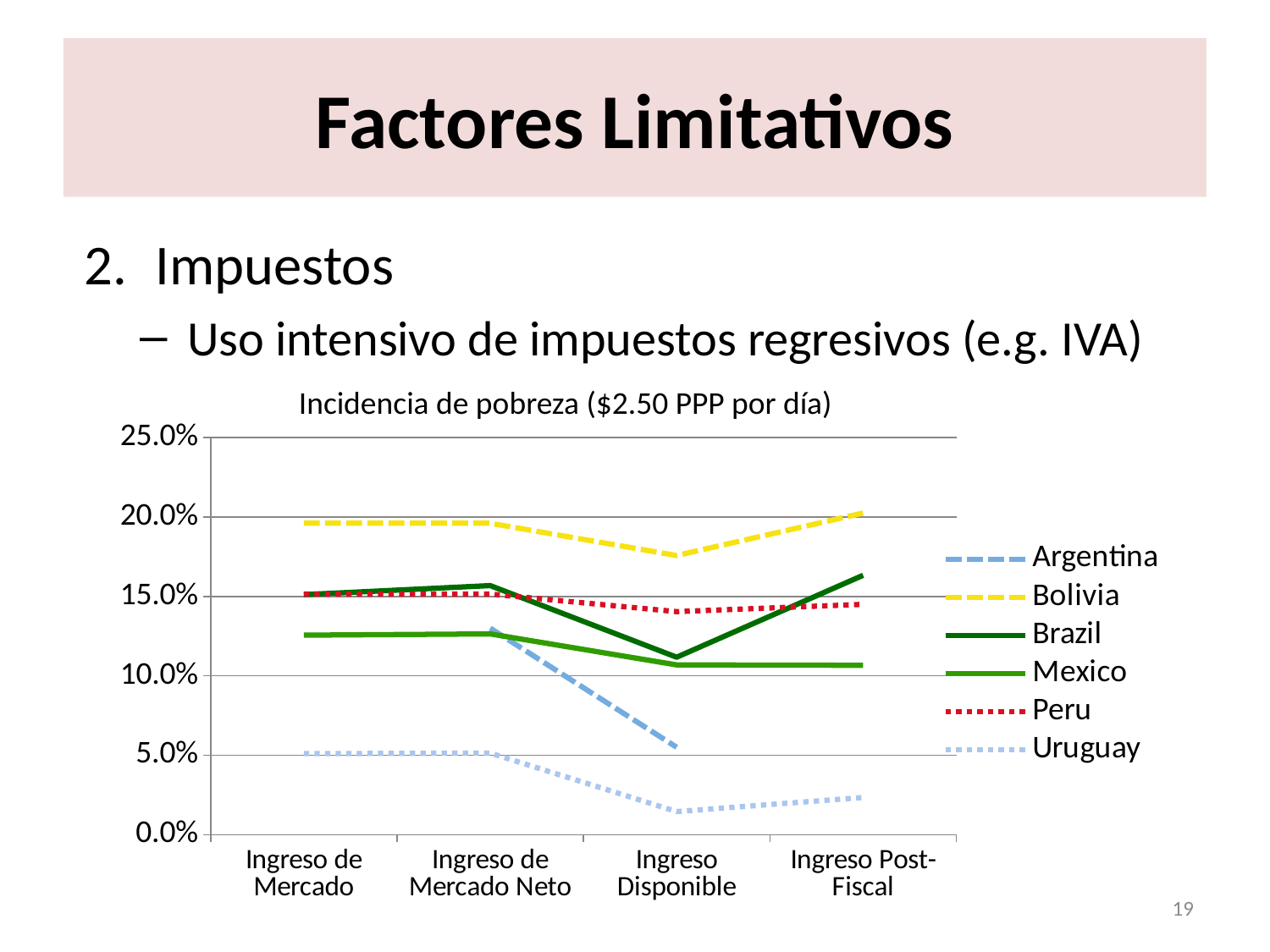
Is the value for Mexico at Ingreso Post-Fiscal greater or less than 15.0%? less What is the title of the chart? Incidencia de pobreza ($2.50 PPP por día) What kind of chart is shown on the slide? line chart Which country has the lowest poverty incidence at Ingreso Disponible? Uruguay At Ingreso de Mercado, which is higher: Bolivia or Peru? Bolivia Which country has the highest poverty incidence at Ingreso Post-Fiscal? Bolivia How many income categories are shown on the x axis? 4 Does the Uruguay line rise or fall from Ingreso de Mercado Neto to Ingreso Disponible? fall At Ingreso Post-Fiscal, which is higher: Brazil or Mexico? Brazil Is the value for Uruguay at Ingreso Disponible greater or less than 5.0%? less Is the value for Bolivia at Ingreso de Mercado greater or less than 15.0%? greater How many series does the legend list? 6